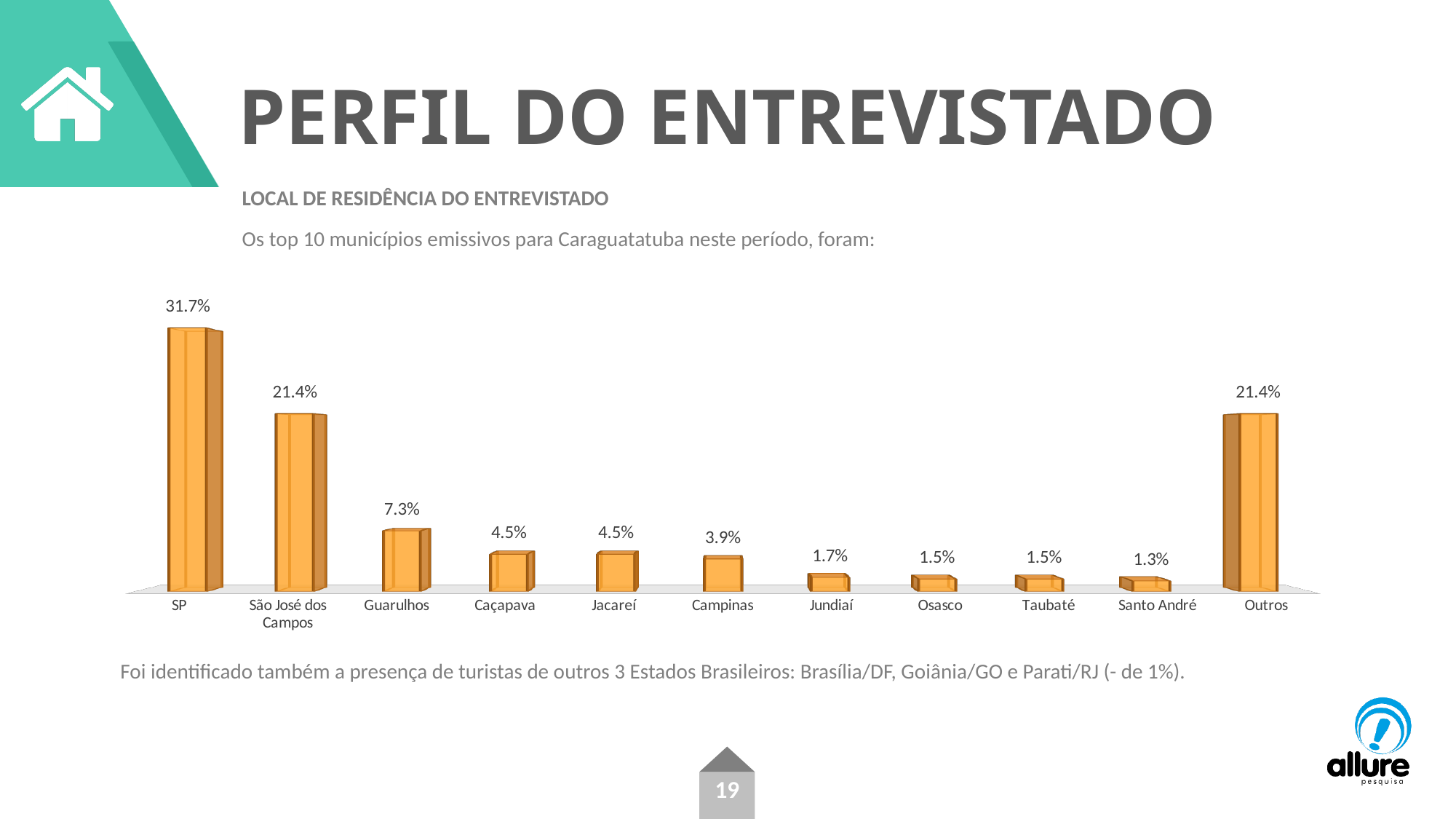
What colour are the bars in the chart? Orange How many categories are shown on the x axis? 11 What is the value for SP? 31.7% Which category has the highest value? SP What kind of chart is shown on the slide? Bar chart What is the value for Campinas? 3.9% What is the value for Outros? 21.4% Which category has the lowest value? Santo André What is the difference between the values for Guarulhos and Jundiaí? 5.6% What is the difference between the values for SP and São José dos Campos? 10.3% Which is larger, the value for Guarulhos or the value for Campinas? Guarulhos What is the value for Guarulhos? 7.3%